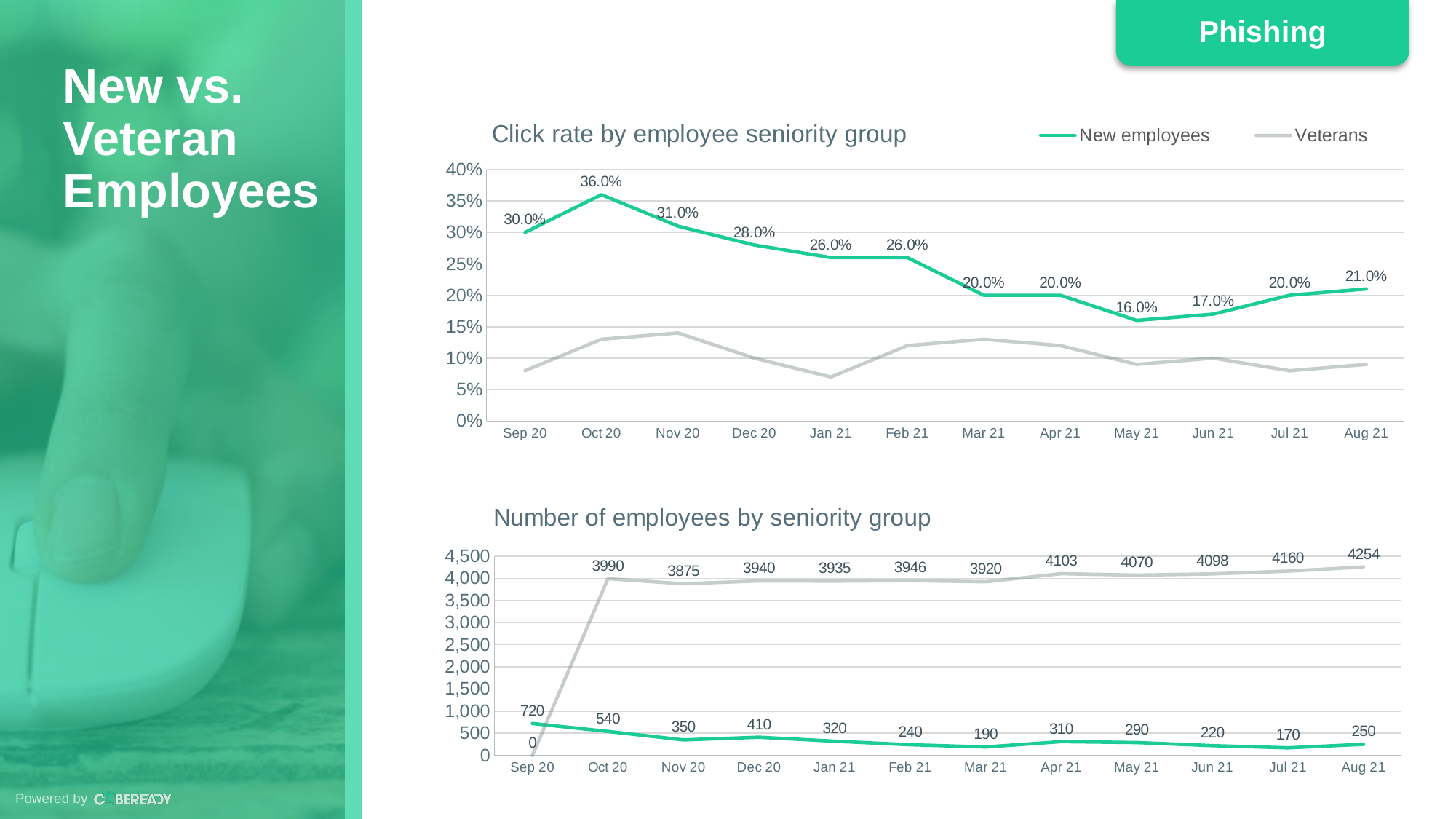
In the 'Click rate by employee seniority group' chart, how many months are shown on the x axis? 12 In the 'Number of employees by seniority group' chart, what is the number of Veterans in Aug 21? 4254 In the 'Click rate by employee seniority group' chart, what is the difference between the New employees click rate in Sep 20 and in Aug 21? 9.0% In the 'Click rate by employee seniority group' chart, is the Veterans click rate in Jan 21 greater or less than 10%? less What kind of chart is 'Number of employees by seniority group'? Line chart In the 'Number of employees by seniority group' chart, what is the number of New employees in Sep 20? 720 In the 'Click rate by employee seniority group' chart, what is the click rate for New employees in Oct 20? 36.0% In the 'Click rate by employee seniority group' chart, how many series does the legend list? 2 In the 'Number of employees by seniority group' chart, what is the difference between the number of Veterans in Aug 21 and in Oct 20? 264 In the 'Click rate by employee seniority group' chart, which month has the lowest click rate for New employees? May 21 In the 'Click rate by employee seniority group' chart, which month has the highest click rate for New employees? Oct 20 In the 'Number of employees by seniority group' chart, which is larger: the number of New employees in Apr 21 or in Jul 21? Apr 21